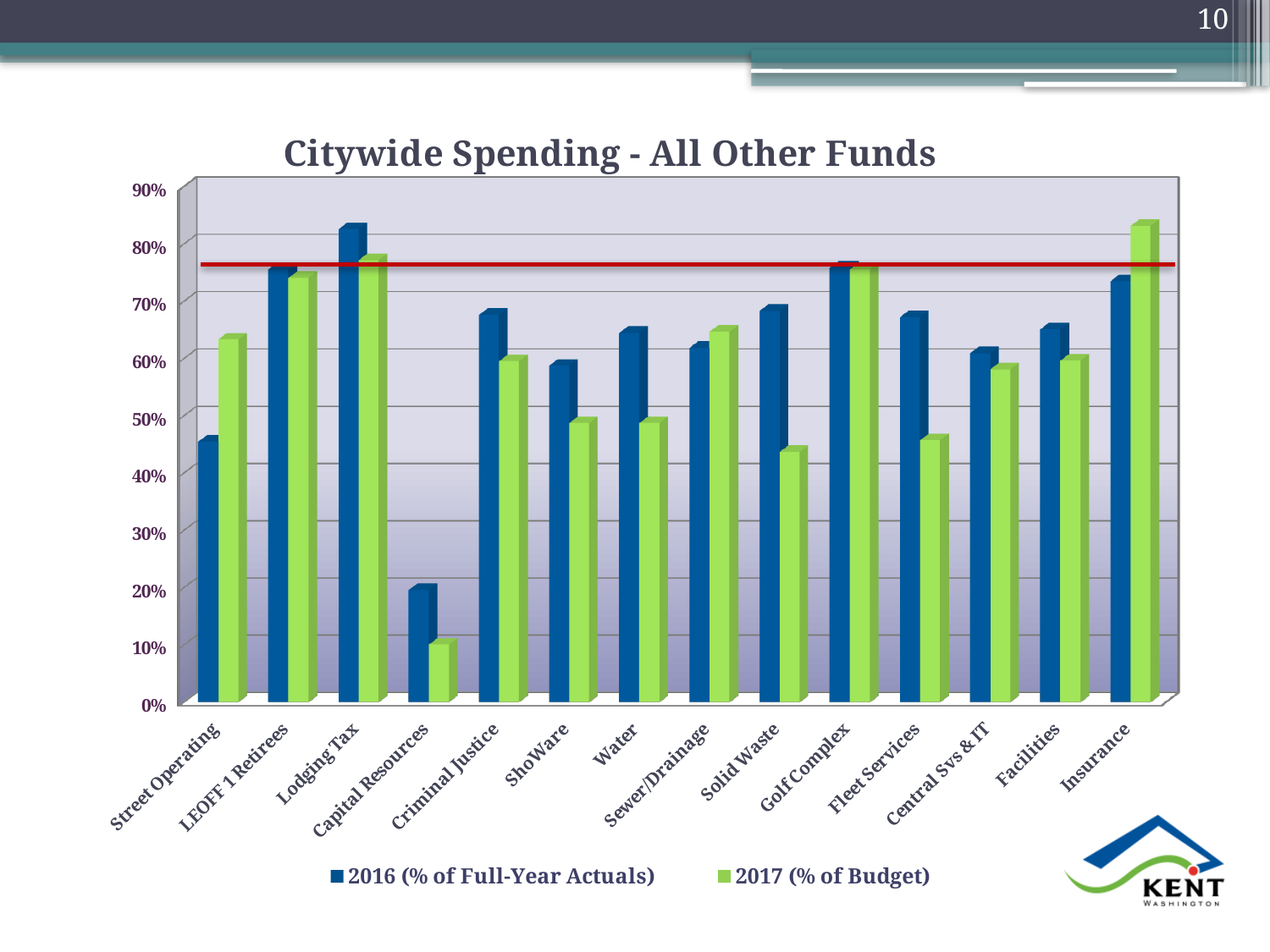
How many categories are shown on the x axis? 14 Which colour represents the 2017 (% of Budget) series in the legend? Green How many series does the legend list? 2 What is the title of the chart? Citywide Spending - All Other Funds Is the 2016 (% of Full-Year Actuals) value for Street Operating greater or less than 50%? less Is the 2017 (% of Budget) value for Solid Waste greater or less than 50%? less Which category has the lowest value for 2016 (% of Full-Year Actuals)? Capital Resources What kind of chart is shown on the slide? Bar chart Is the 2017 (% of Budget) value for Insurance greater or less than 80%? greater For Street Operating, which series has the larger value: 2016 (% of Full-Year Actuals) or 2017 (% of Budget)? 2017 (% of Budget) Which category has the highest value for 2017 (% of Budget)? Insurance Which category has the highest value for 2016 (% of Full-Year Actuals)? Lodging Tax